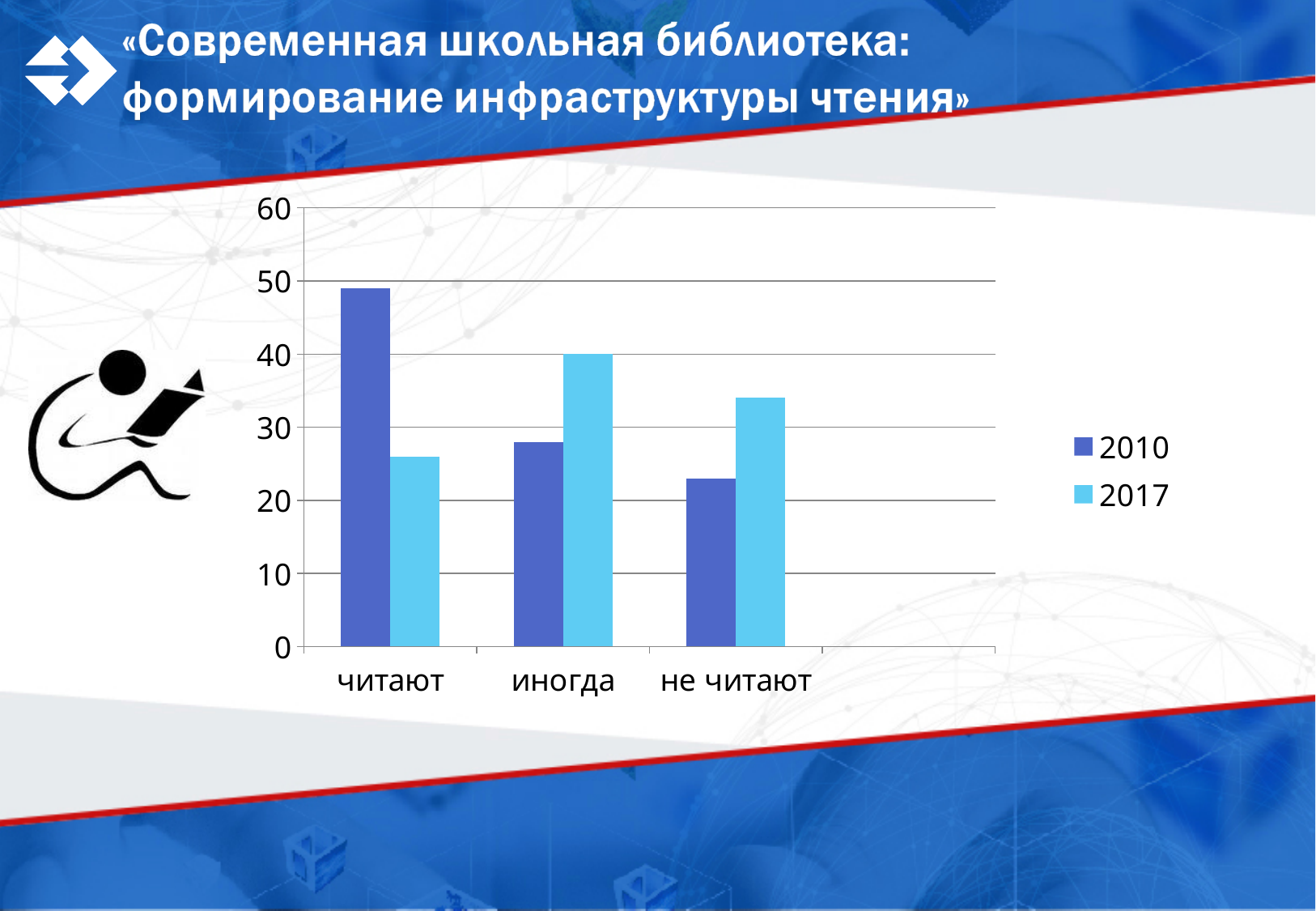
Is the 2010 value for читают greater or less than 40? greater For the category не читают, which series has the larger value, 2010 or 2017? 2017 Which category has the lowest value for the 2017 series? читают For the category читают, which series has the larger value, 2010 or 2017? 2010 Which category has the lowest value for the 2010 series? не читают Is the 2017 value for читают greater or less than 30? less How many series does the chart's legend list? 2 Do the values of the 2010 series rise or fall from читают to не читают along the x axis? fall Which category has the highest value for the 2010 series? читают How many categories are shown on the x axis of the chart? 3 What kind of chart is shown on the slide? bar chart Which category has the highest value for the 2017 series? иногда